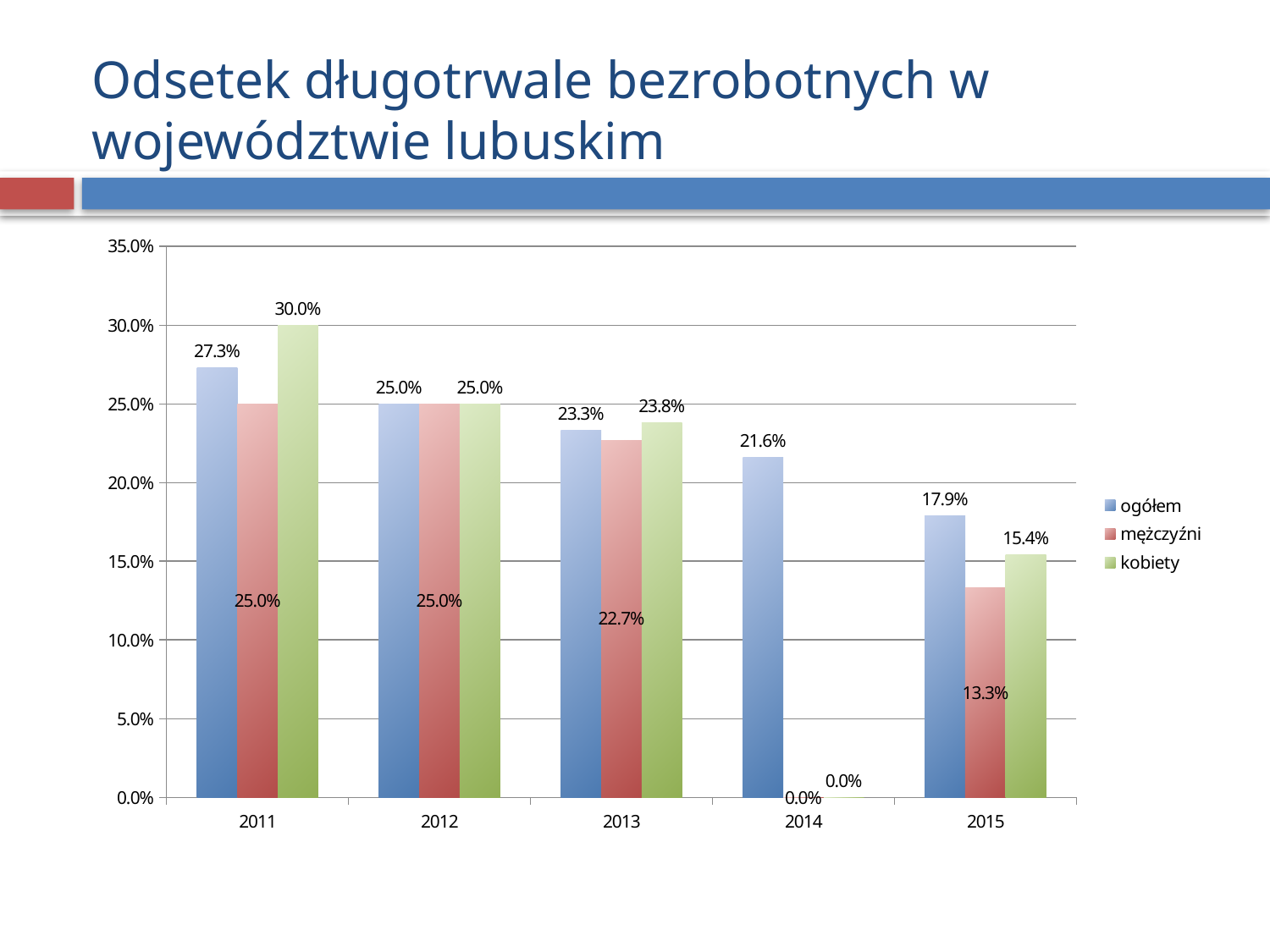
What is the value for ogółem in 2014? 21.6% How many years are shown on the x axis? 5 In which year is the ogółem value highest? 2011 What is the value for kobiety in 2011? 30.0% What is the value for ogółem in 2011? 27.3% What is the value for mężczyźni in 2015? 13.3% What kind of chart is shown on the slide? bar chart Which is larger in 2013, the value for mężczyźni or the value for kobiety? kobiety How many series does the legend list? 3 What is the difference between the kobiety value in 2011 and the kobiety value in 2015? 14.6% In which year is the ogółem value lowest? 2015 Does the ogółem value rise or fall from 2011 to 2015? fall